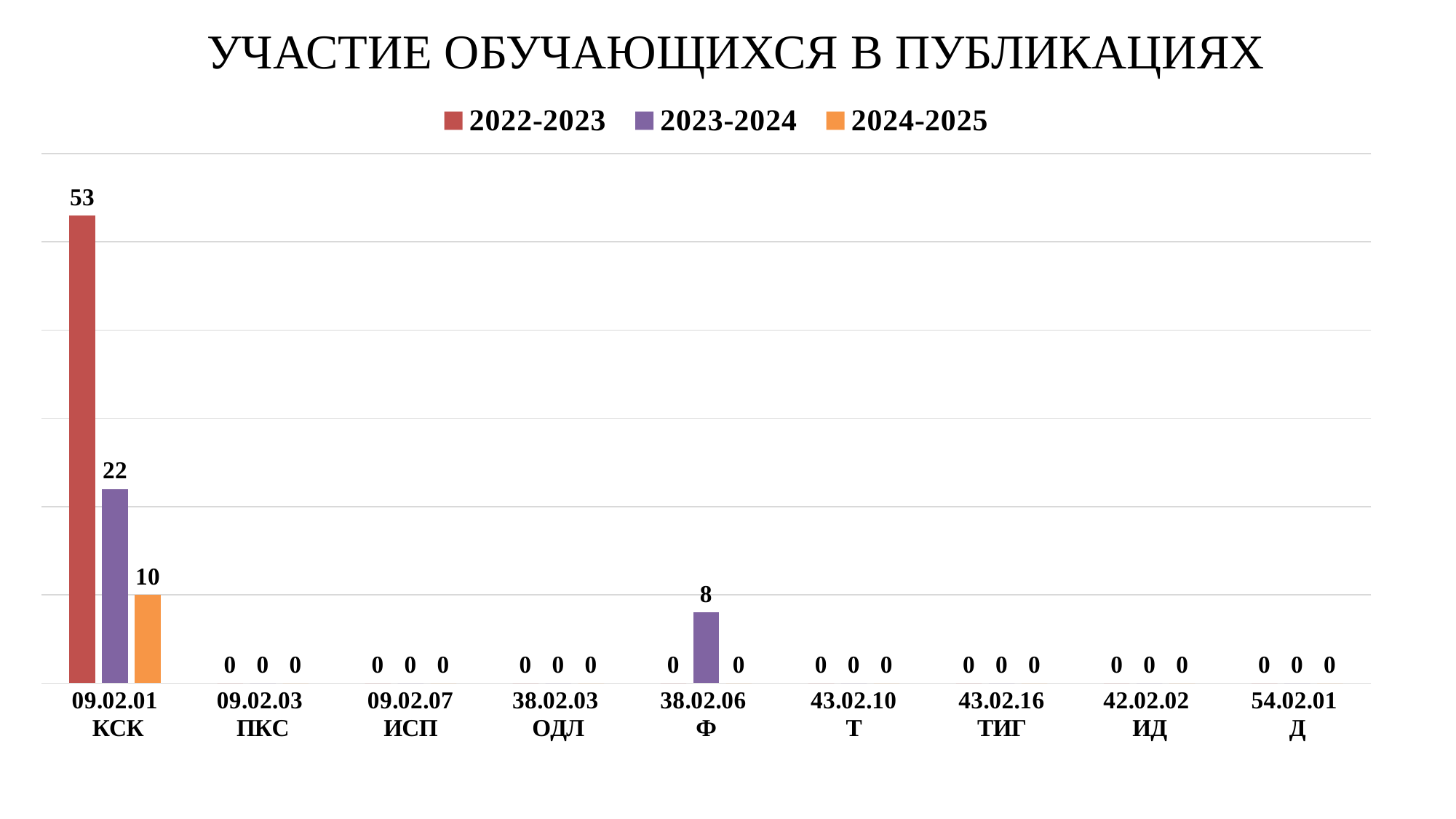
What is the value for 09.02.01 КСК in the 2022-2023 series? 53 What is the value for 09.02.01 КСК in the 2024-2025 series? 10 What kind of chart is shown on the slide? Bar chart How many series does the legend list? 3 What is the value for 09.02.01 КСК in the 2023-2024 series? 22 Which category has the highest value in the 2023-2024 series? 09.02.01 КСК How many categories are shown on the x axis? 9 What is the difference between the 2022-2023 and 2023-2024 values for 09.02.01 КСК? 31 Which is larger for 09.02.01 КСК: the 2023-2024 value or the 2024-2025 value? 2023-2024 What is the value for 43.02.10 Т in the 2022-2023 series? 0 What is the value for 38.02.06 Ф in the 2023-2024 series? 8 What is the title of the chart? УЧАСТИЕ ОБУЧАЮЩИХСЯ В ПУБЛИКАЦИЯХ